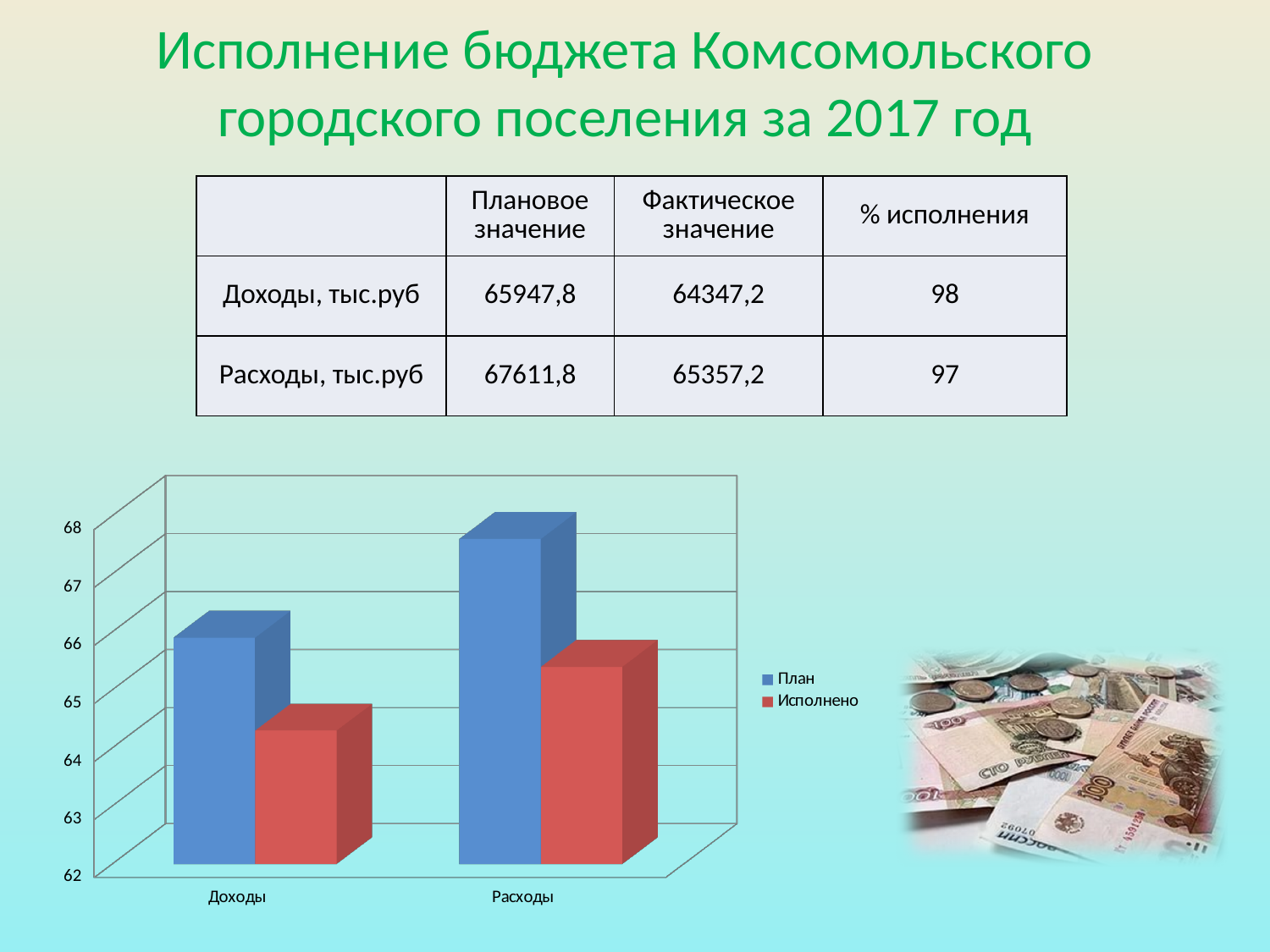
In the chart, which is larger: the План bar for Доходы or the План bar for Расходы? Расходы In the chart, is the План bar for Расходы greater or less than 67? greater Which category has the shortest Исполнено bar in the chart? Доходы In the chart, is the План bar for Доходы greater or less than 65? greater Which category has the tallest План bar in the chart? Расходы In the chart, is the Исполнено bar for Расходы greater or less than 67? less Which colour represents the Исполнено series in the chart legend? red How many series does the chart legend list? 2 How many categories are shown on the x axis of the chart? 2 Do the Исполнено bars rise or fall from Доходы to Расходы in the chart? rise What kind of chart is shown on the slide? bar chart